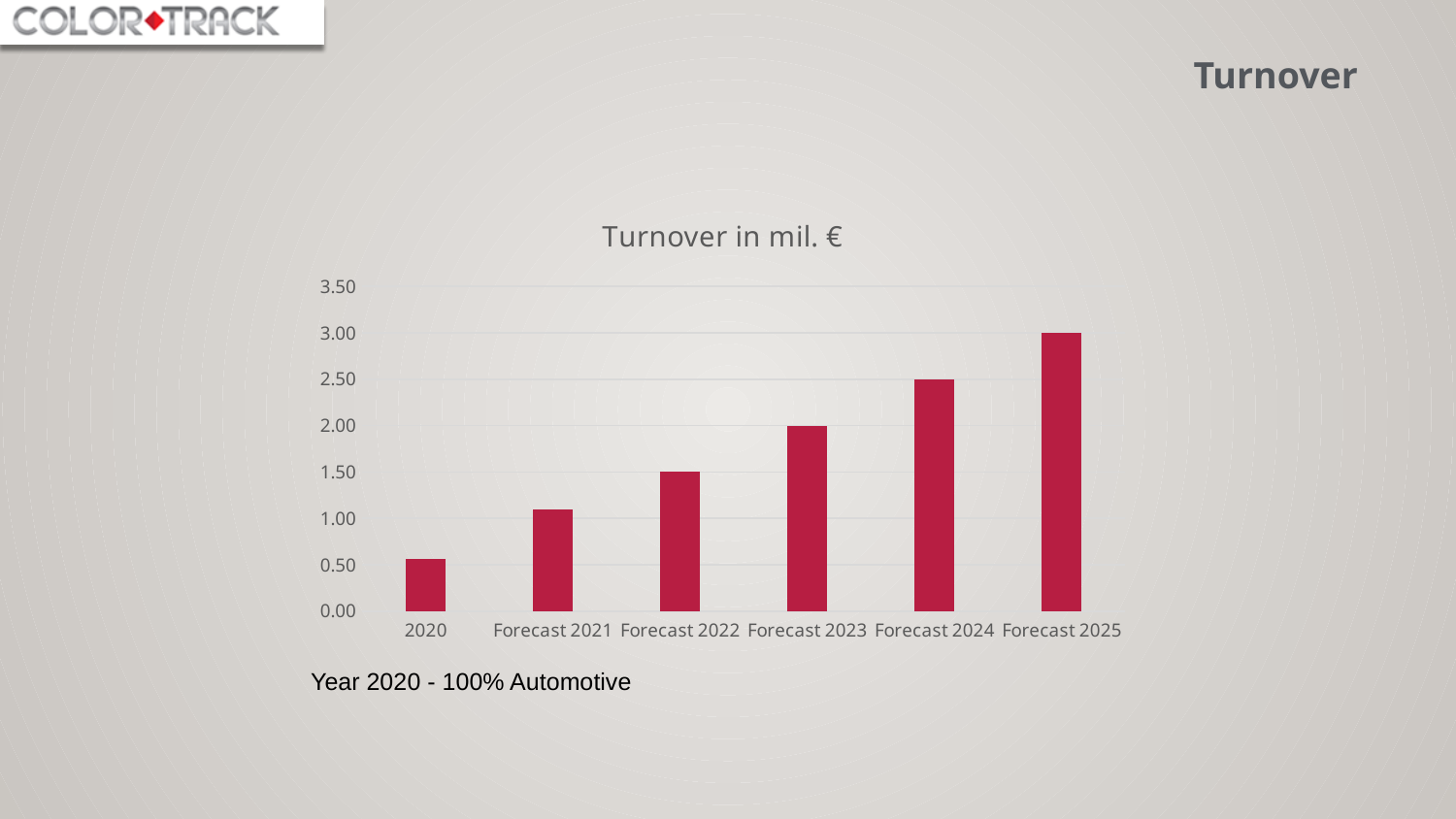
What is the difference between the turnover for Forecast 2025 and Forecast 2023? 1.00 What is the title of the chart? Turnover in mil. € Do the turnover values rise or fall from 2020 to Forecast 2025? rise What is the turnover value for Forecast 2025? 3.00 What kind of chart is shown on the slide? bar chart How many categories are shown on the x axis of the chart? 6 Is the turnover value for Forecast 2021 greater or less than 1.00? greater Is the turnover value for 2020 greater or less than 1.00? less Which is larger, the turnover for Forecast 2022 or Forecast 2024? Forecast 2024 Which category has the lowest turnover? 2020 What is the turnover value for Forecast 2023? 2.00 Which category has the highest turnover? Forecast 2025